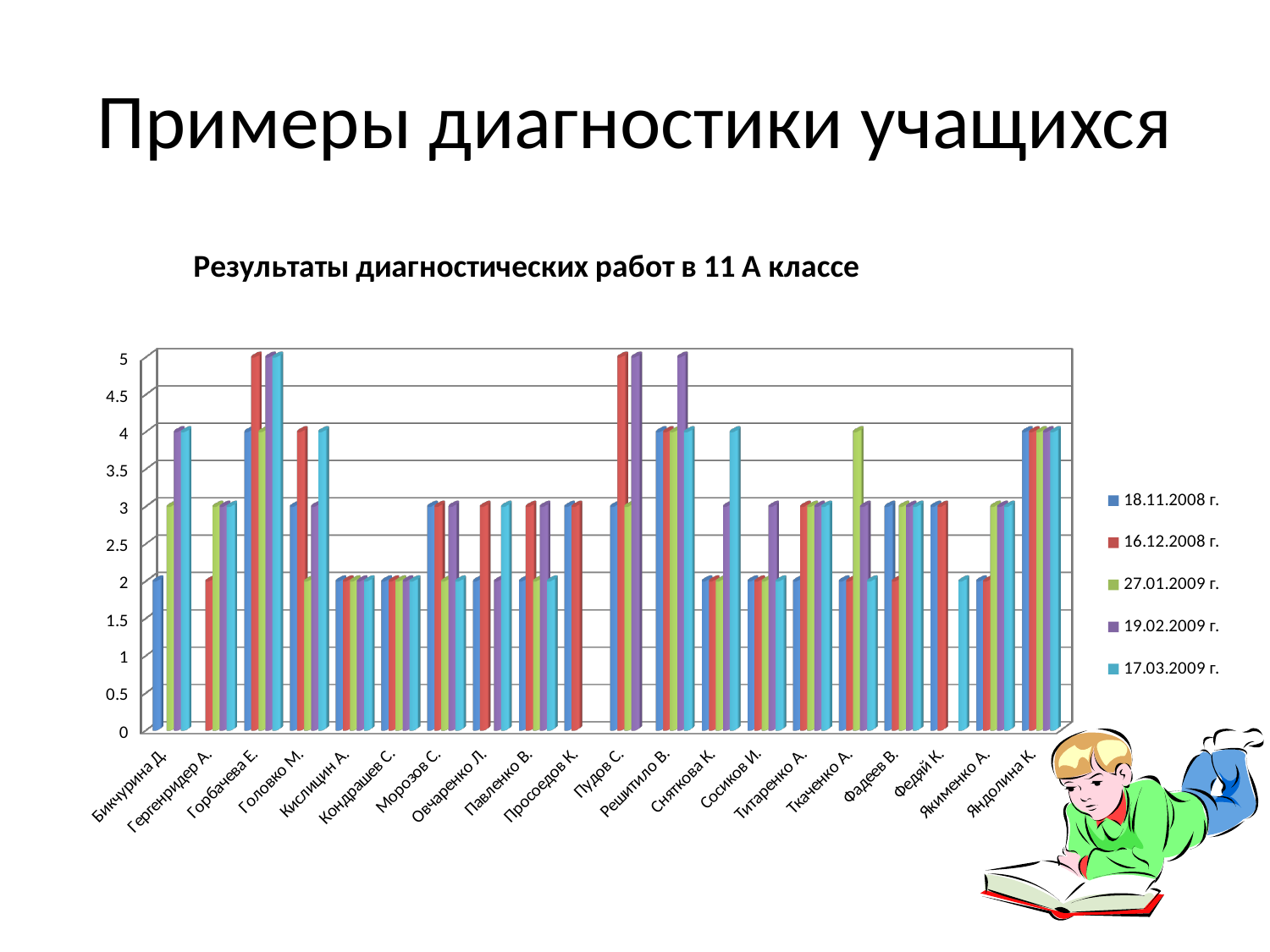
Which is larger for the 18.11.2008 г. series: the value for Горбачева Е. or the value for Кондрашев С.? Горбачева Е. What is the value for Кислицин А. in the 18.11.2008 г. series? 2 What is the title of the chart? Результаты диагностических работ в 11 А классе How many series does the legend list? 5 What is the value for Яндолина К. in the 17.03.2009 г. series? 4 What is the difference between the 16.12.2008 г. value for Горбачева Е. and the 16.12.2008 г. value for Кислицин А.? 3 What is the value for Горбачева Е. in the 16.12.2008 г. series? 5 What kind of chart is shown on the slide? bar chart Is the value for Сосиков И. in the 27.01.2009 г. series greater or less than 3? less Is the value for Решитило В. in the 19.02.2009 г. series greater or less than 4? greater How many students (categories) are shown on the x axis? 20 Which date is the first entry in the legend? 18.11.2008 г.